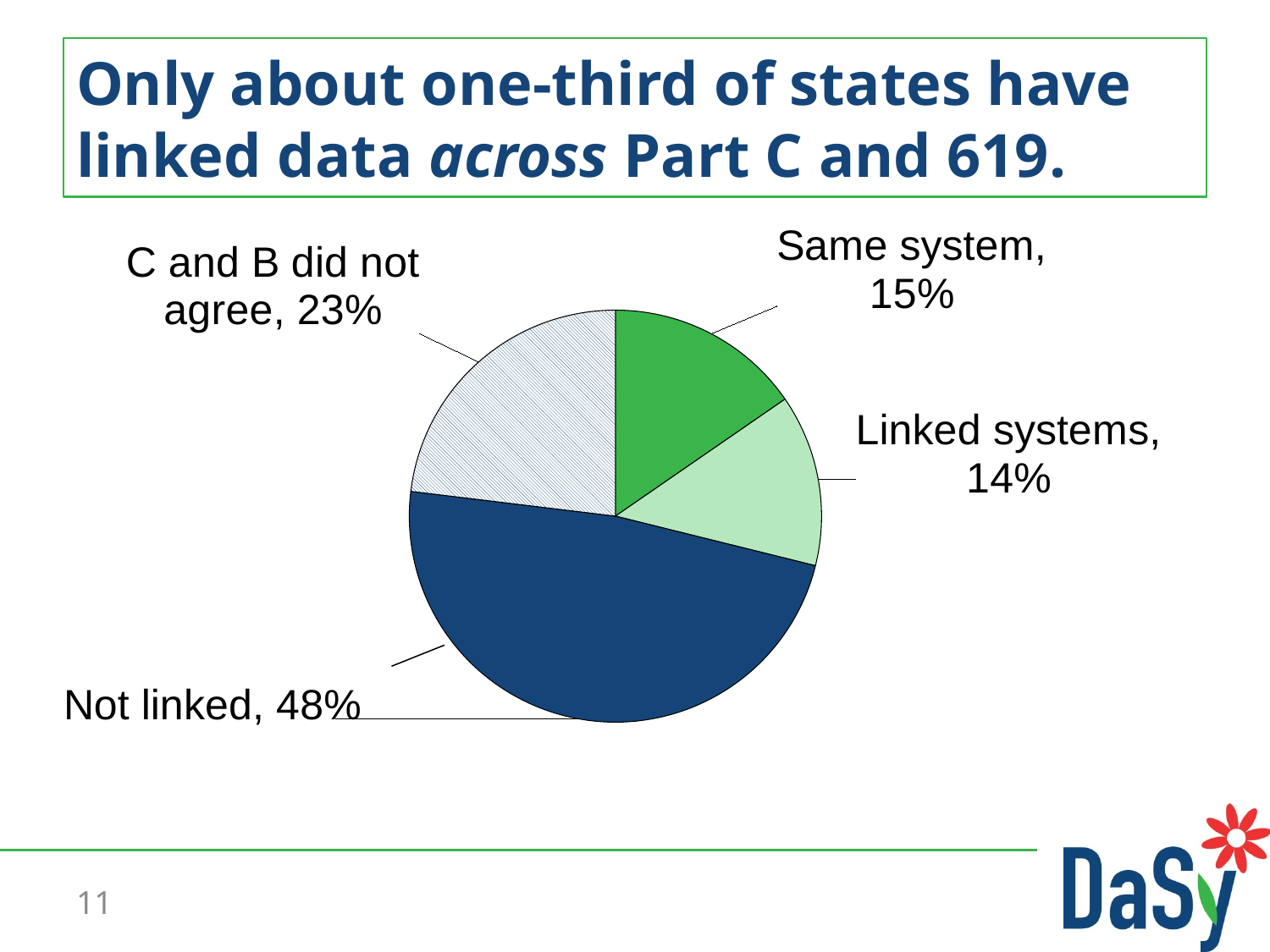
Which slice of the pie is drawn with a hatched pattern? C and B did not agree What percentage is shown for 'Linked systems'? 14% Which category has the largest share of the pie? Not linked What is the combined percentage of 'Same system' and 'Linked systems'? 29% What percentage is shown for 'Same system'? 15% Which category has the smallest share of the pie? Linked systems What percentage is shown for 'C and B did not agree'? 23% What type of chart is shown on the slide? pie chart What percentage of states are in the 'Not linked' category? 48% How many slices does the pie chart have? 4 What is the difference in percentage points between 'Not linked' and 'C and B did not agree'? 25 Which is larger: 'Same system' or 'Linked systems'? Same system